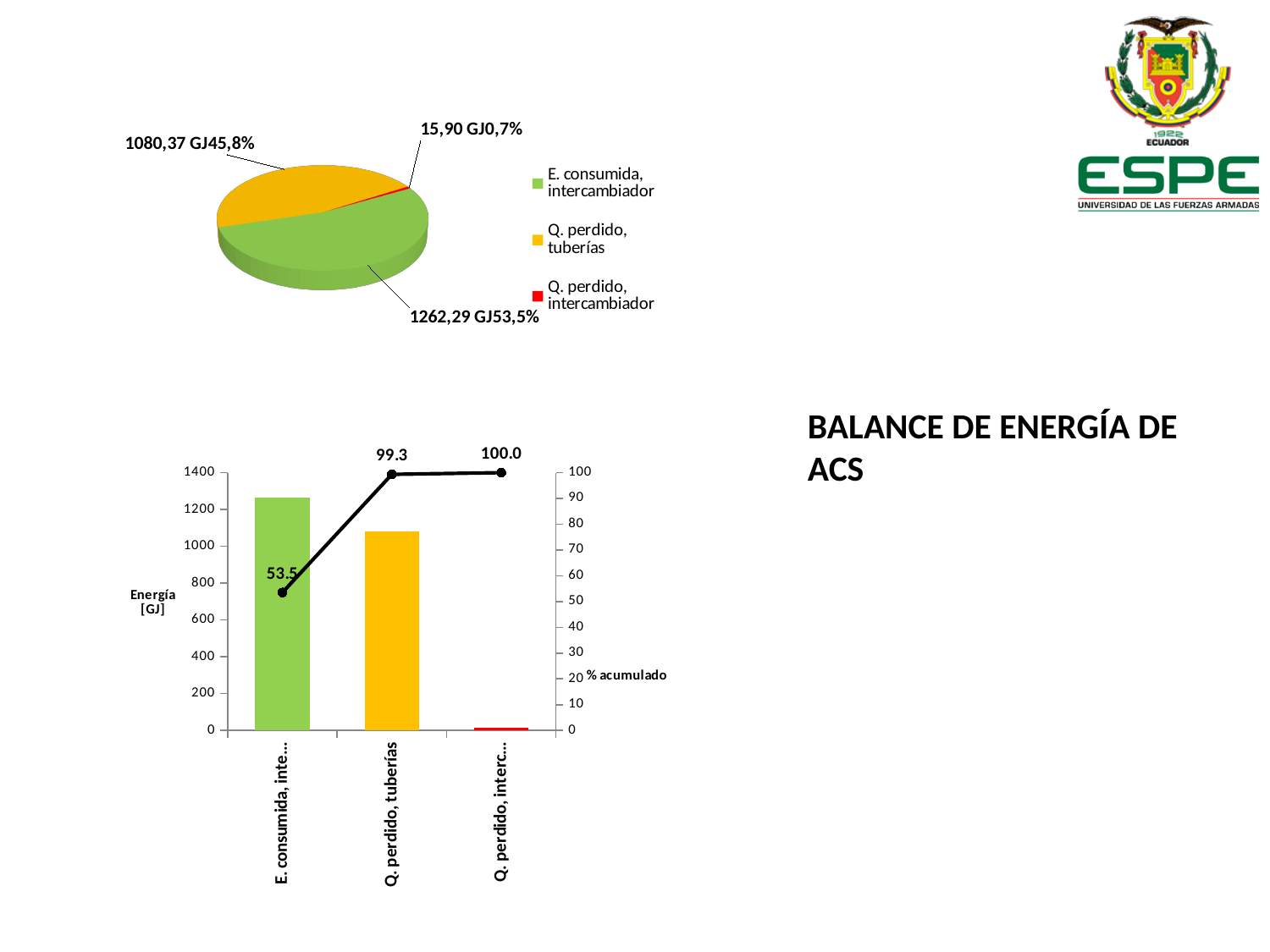
In the bottom chart, is the bar for Q. perdido, tuberías greater or less than 1000 GJ? greater In the pie chart at the top of the slide, what colour is the Q. perdido, tuberías slice? Yellow In the bottom chart, which category has the tallest bar? E. consumida, inte... In the bottom chart, what is the % acumulado value at Q. perdido, tuberías? 99.3 In the pie chart at the top of the slide, what value is shown for Q. perdido, intercambiador? 15,90 GJ In the pie chart at the top of the slide, what value is shown for Q. perdido, tuberías? 1080,37 GJ How many slices does the pie chart at the top of the slide have? 3 In the bottom chart, what is the % acumulado value at the first category, E. consumida? 53.5 In the pie chart at the top of the slide, what share does the E. consumida, intercambiador slice have? 53,5% What kind of chart is the chart at the top of the slide? Pie chart In the bottom chart, does the % acumulado line rise or fall from left to right? Rises In the pie chart at the top of the slide, which category has the smallest slice? Q. perdido, intercambiador